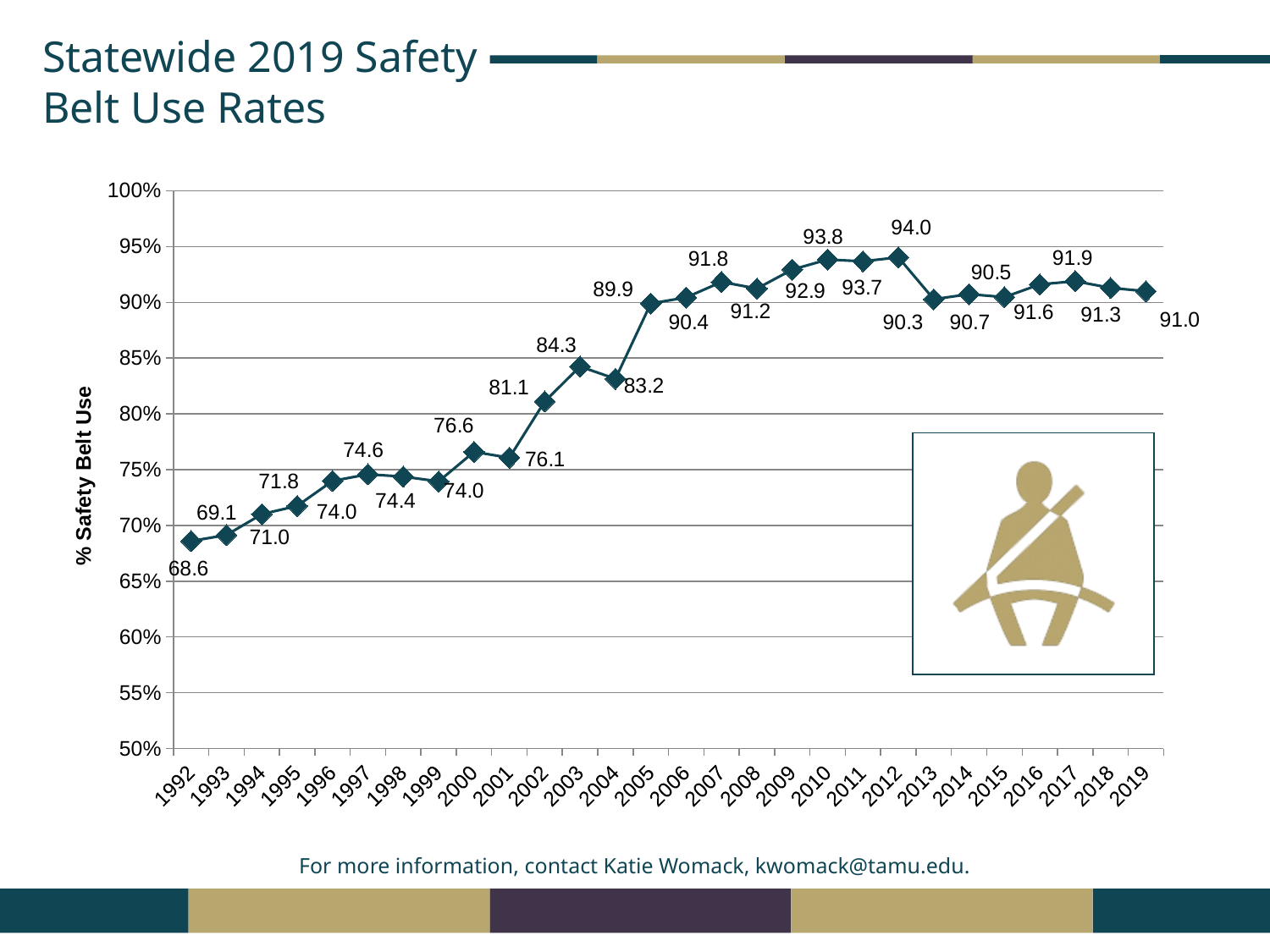
Which year has the lowest safety belt use rate? 1992 What is the difference between the 2012 value and the 2013 value? 3.7 What is the safety belt use rate for 1992? 68.6 What kind of chart is shown on the slide? line chart What is the safety belt use rate for 2005? 89.9 How many years are plotted on the x axis? 28 Do the values generally rise or fall from 1992 to 2012? rise What is the label on the y axis? % Safety Belt Use Which year has a higher safety belt use rate, 2003 or 2004? 2003 What is the safety belt use rate for 2019? 91.0 Which year has the highest safety belt use rate? 2012 Is the value for 2002 greater or less than 80%? greater